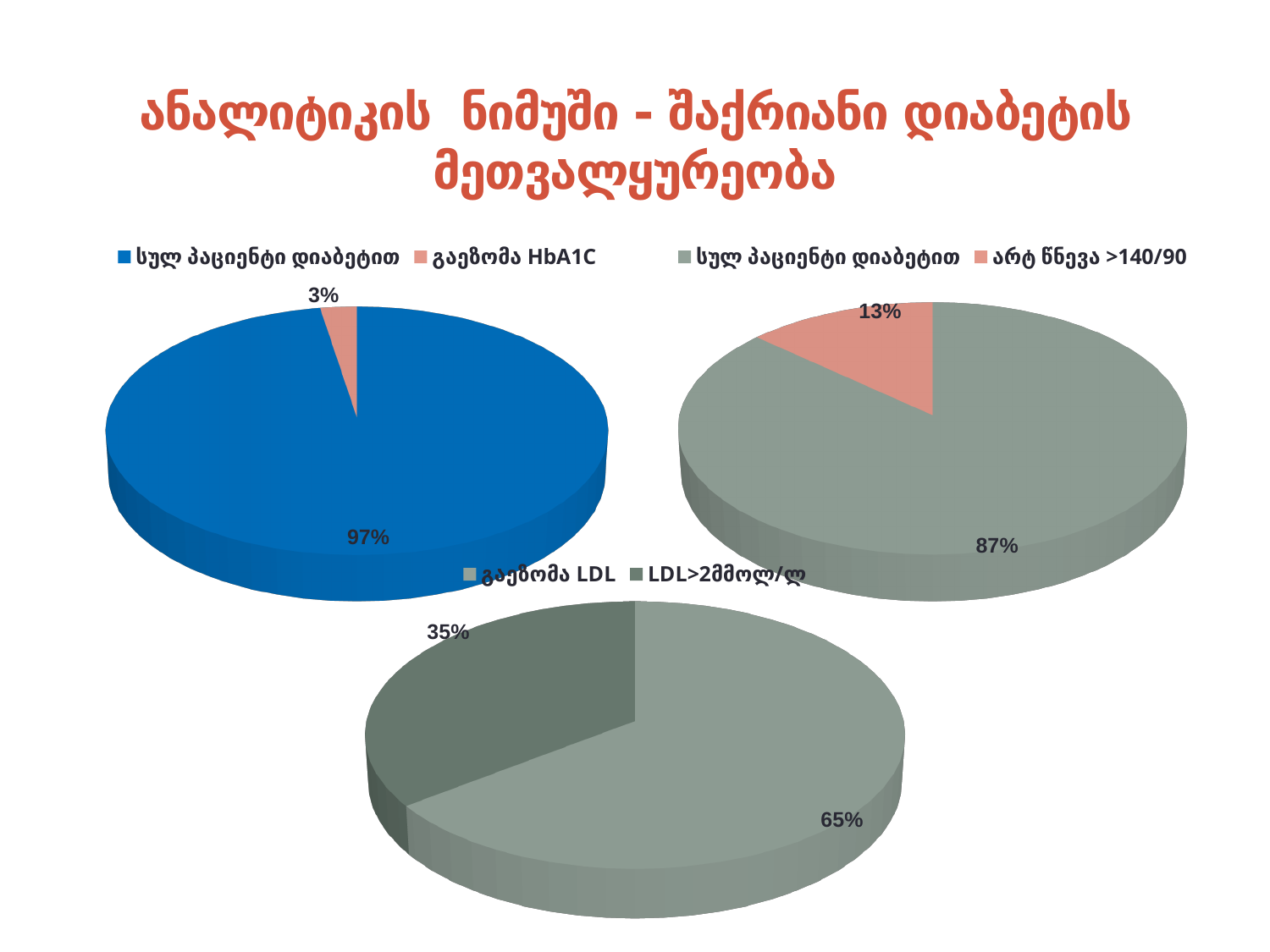
In the top-left pie chart, what percentage is shown for the slice labelled გაზომა HbA1C? 3% In the top-left pie chart, what percentage is shown for the slice labelled სულ პაციენტი დიაბეტით? 97% How many series does the legend of the bottom pie chart list? 2 In the bottom pie chart, what is the difference in percentage points between the გაზომა LDL slice and the LDL>2მმოლ/ლ slice? 30 In the bottom pie chart, what percentage is shown for the slice labelled LDL>2მმოლ/ლ? 35% In the bottom pie chart, what percentage is shown for the slice labelled გაზომა LDL? 65% How many pie charts are shown on the slide? 3 In the top-right pie chart, which slice is the smallest? არტ წნევა >140/90 In the top-right pie chart, what percentage is shown for the slice labelled არტ წნევა >140/90? 13% In the top-right pie chart, what percentage is shown for the slice labelled სულ პაციენტი დიაბეტით? 87% In the bottom pie chart, which slice is the largest? გაზომა LDL What type of chart is the top-left chart? Pie chart